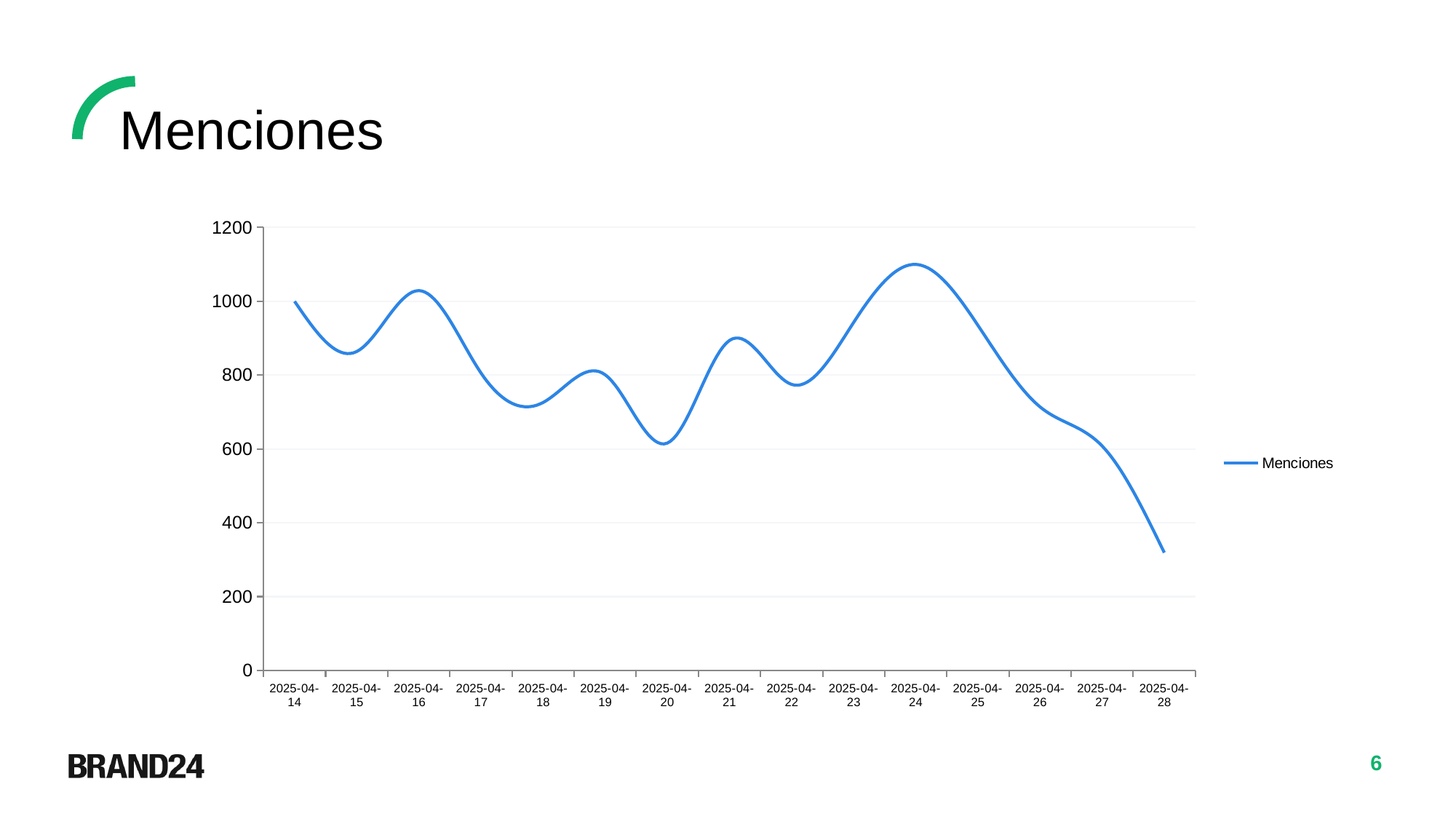
How many dates are plotted along the x axis? 15 Is the value for 2025-04-24 greater or less than 1000? greater Which date has more Menciones, 2025-04-20 or 2025-04-22? 2025-04-22 What kind of chart is shown on the slide? line chart Is the value for 2025-04-20 greater or less than 800? less Is the value for 2025-04-18 greater or less than 800? less How many series does the legend list? 1 On which date is the number of Menciones highest? 2025-04-24 On which date is the number of Menciones lowest? 2025-04-28 Overall, do the Menciones values rise or fall from 2025-04-14 to 2025-04-28? fall What is the name of the series shown in the legend? Menciones